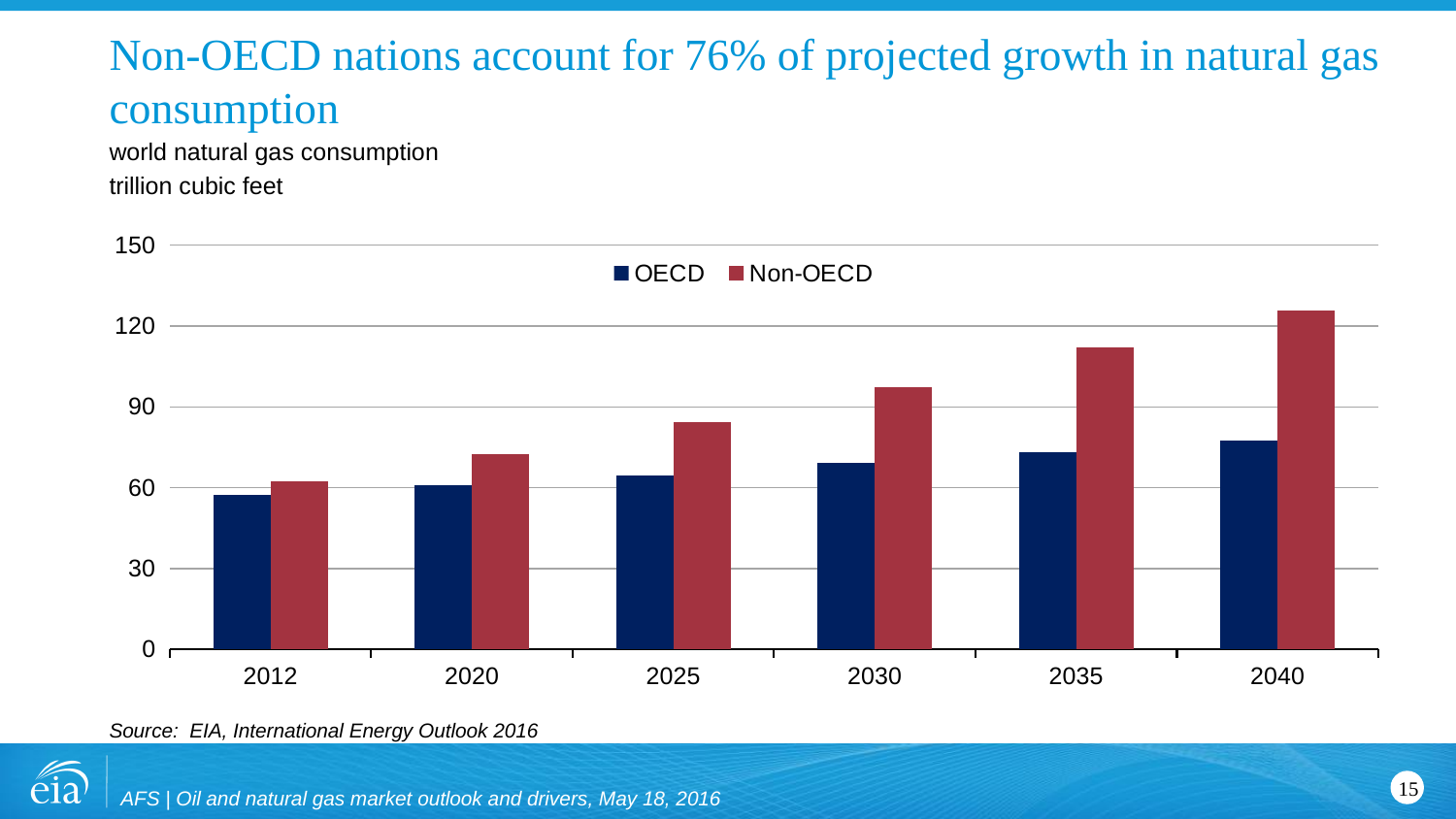
Is the OECD value for 2040 greater or less than 90? less Is the Non-OECD value for 2040 greater or less than 120? greater In which year is the Non-OECD bar highest? 2040 What kind of chart is shown on the slide? bar chart How many years are shown on the x axis? 6 Is the OECD value for 2012 greater or less than 60? less In which year is the OECD bar lowest? 2012 Do the Non-OECD values rise or fall from 2012 to 2040? rise What unit is the natural gas consumption measured in? trillion cubic feet In 2040, which is larger, OECD or Non-OECD consumption? Non-OECD How many series does the legend list? 2